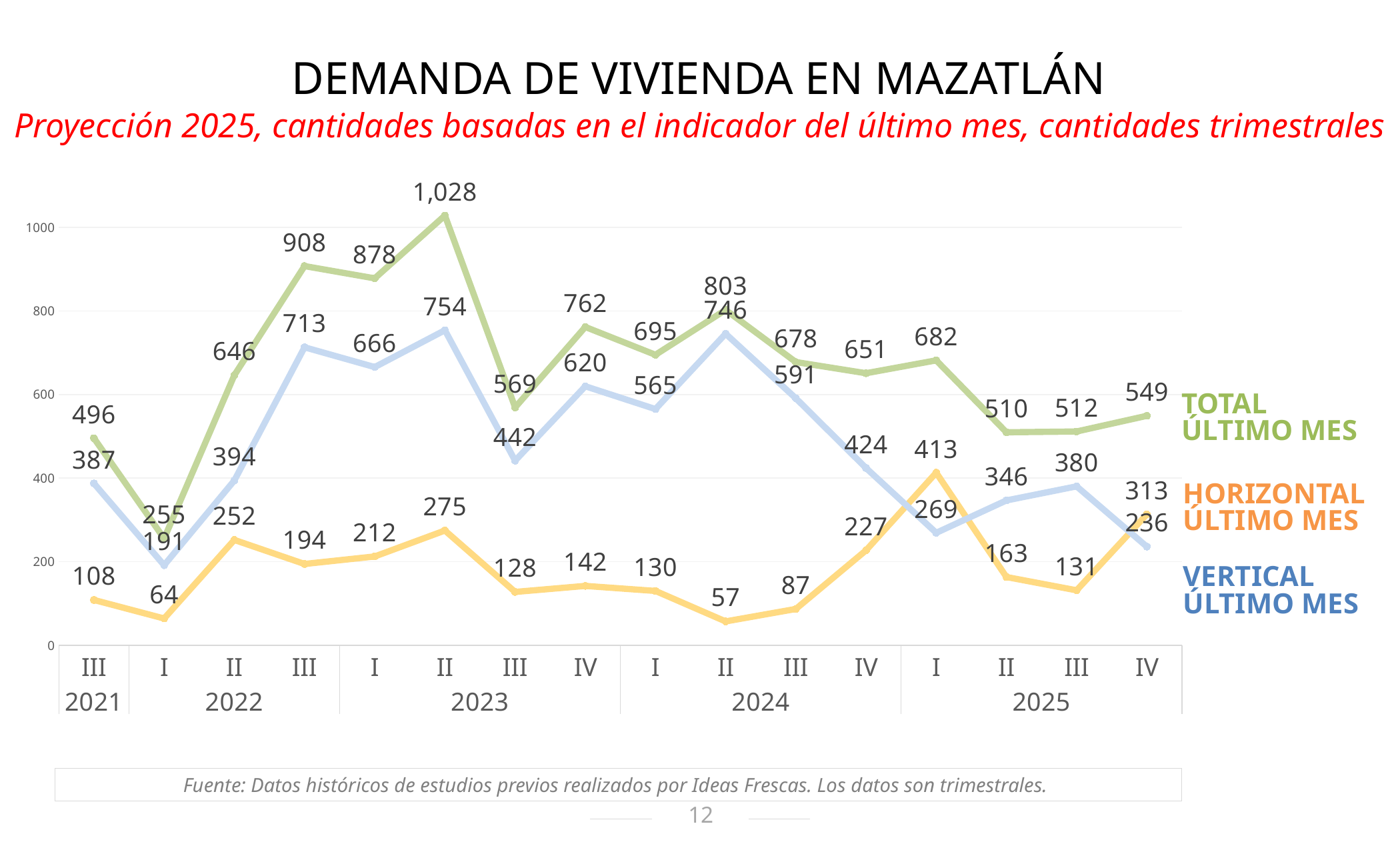
What is the value of TOTAL ÚLTIMO MES in quarter II of 2023? 1,028 Which is larger in quarter I of 2025: HORIZONTAL ÚLTIMO MES or VERTICAL ÚLTIMO MES? HORIZONTAL ÚLTIMO MES What is the difference between TOTAL ÚLTIMO MES in quarter III of 2022 and quarter I of 2023? 30 What type of chart is shown on the slide? line chart In which quarter does HORIZONTAL ÚLTIMO MES reach its lowest value? II 2024 What colour is the line for VERTICAL ÚLTIMO MES? blue How many quarters are plotted on the x axis? 16 Does TOTAL ÚLTIMO MES rise or fall from quarter I of 2025 to quarter II of 2025? fall What is the value of VERTICAL ÚLTIMO MES in quarter II of 2024? 746 What is the value of HORIZONTAL ÚLTIMO MES in quarter I of 2025? 413 In which quarter does TOTAL ÚLTIMO MES reach its highest value? II 2023 How many series does the legend list? 3